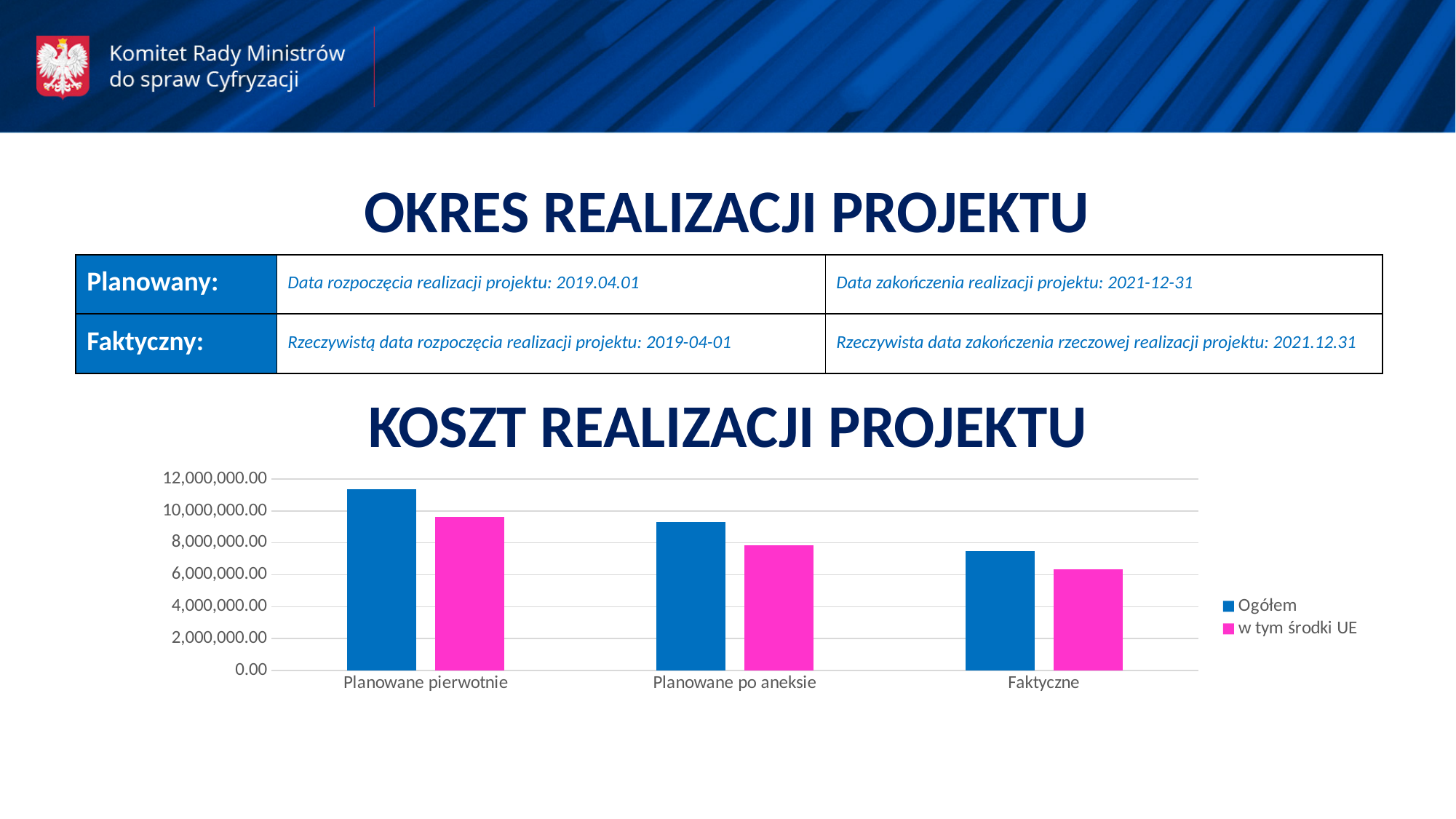
Which category has the lowest w tym środki UE value in the KOSZT REALIZACJI PROJEKTU chart? Faktyczne In the KOSZT REALIZACJI PROJEKTU chart, is the Ogółem value for Faktyczne greater or less than 6,000,000.00? greater In the KOSZT REALIZACJI PROJEKTU chart, is the Ogółem value for Planowane po aneksie larger or smaller than the Ogółem value for Faktyczne? larger Do the Ogółem values rise or fall from Planowane pierwotnie to Faktyczne in the KOSZT REALIZACJI PROJEKTU chart? fall What is the title of the chart on the slide? KOSZT REALIZACJI PROJEKTU How many series does the legend of the KOSZT REALIZACJI PROJEKTU chart list? 2 In the KOSZT REALIZACJI PROJEKTU chart, is the w tym środki UE value for Faktyczne greater or less than 8,000,000.00? less Which colour represents the w tym środki UE series in the KOSZT REALIZACJI PROJEKTU chart? pink In the KOSZT REALIZACJI PROJEKTU chart, is the Ogółem value for Planowane pierwotnie greater or less than 10,000,000.00? greater How many categories are shown on the x axis of the KOSZT REALIZACJI PROJEKTU chart? 3 Which category has the highest Ogółem value in the KOSZT REALIZACJI PROJEKTU chart? Planowane pierwotnie What kind of chart is shown under the title KOSZT REALIZACJI PROJEKTU? bar chart